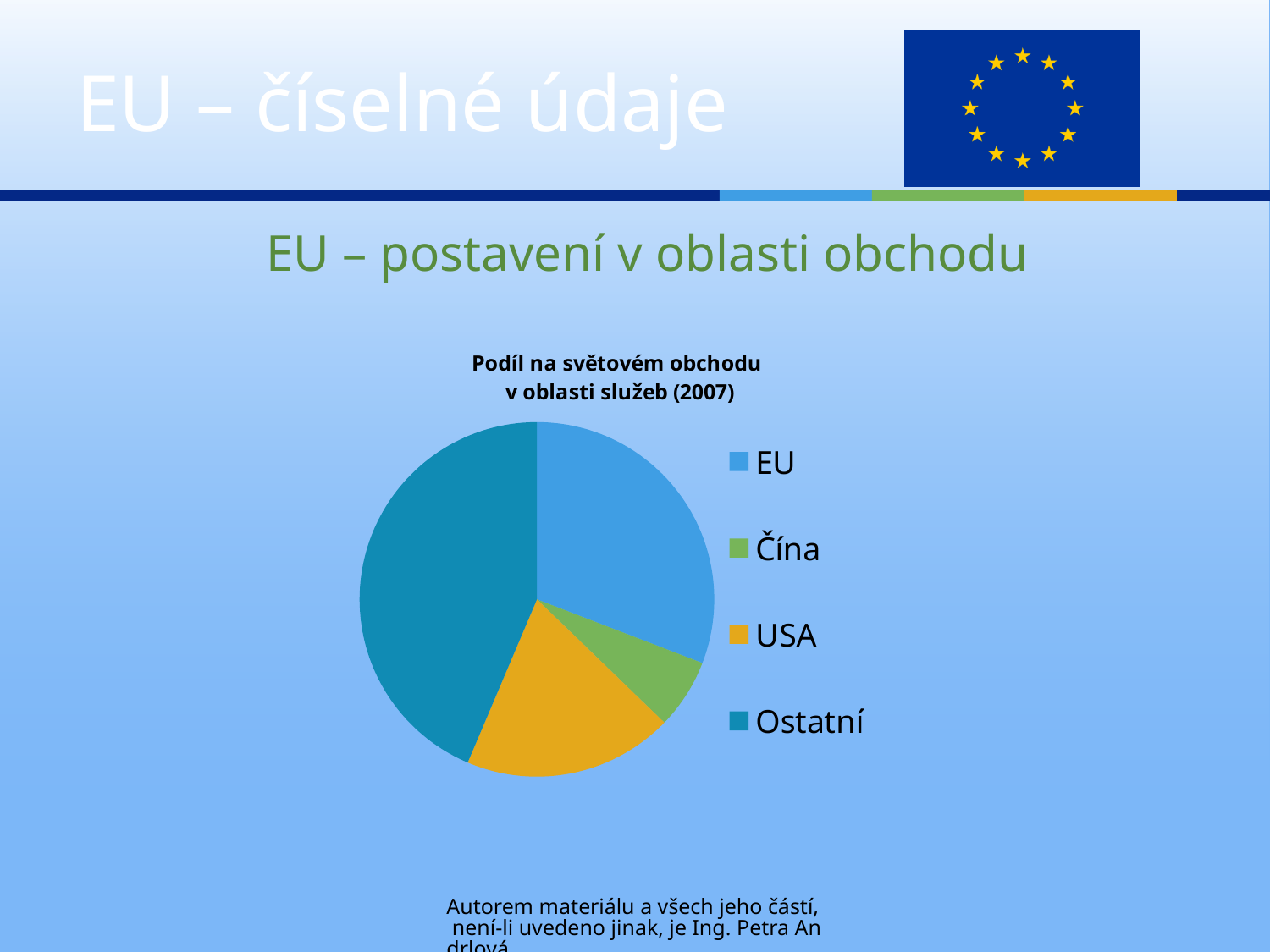
How many slices does the pie chart have? 4 How many entries does the legend of the pie chart list? 4 Which slice is larger in the pie chart, Čína or USA? USA What colour is the slice for Čína in the pie chart? green What is the title of the pie chart? Podíl na světovém obchodu v oblasti služeb (2007) Which category has the smallest slice in the pie chart? Čína What kind of chart is shown on the slide? pie chart Which category has the largest slice in the pie chart? Ostatní Which year does the pie chart's title refer to? 2007 Which slice is larger in the pie chart, Ostatní or EU? Ostatní Which slice is larger in the pie chart, EU or USA? EU